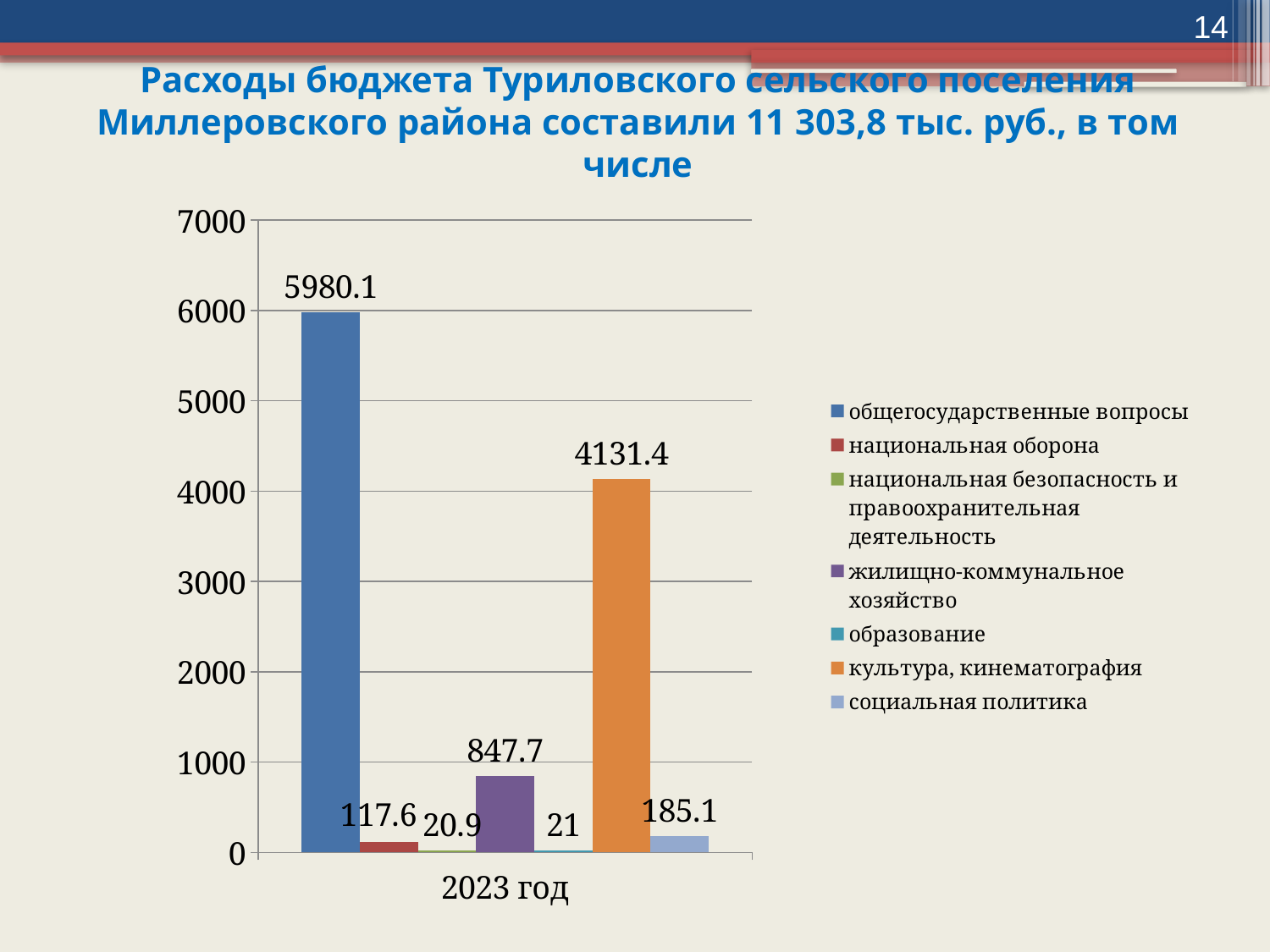
Which is larger: жилищно-коммунальное хозяйство or социальная политика? жилищно-коммунальное хозяйство What is the value for социальная политика in 2023 год? 185.1 What is the value for культура, кинематография in 2023 год? 4131.4 What is the x-axis category label shown under the bars? 2023 год Which series has the highest value in 2023 год? общегосударственные вопросы What is the difference between общегосударственные вопросы and культура, кинематография? 1848.7 How many series does the legend list? 7 What is the value for общегосударственные вопросы in 2023 год? 5980.1 What is the value for национальная оборона in 2023 год? 117.6 Is the value for культура, кинематография greater or less than 4000? greater What type of chart is shown on the slide? bar chart What is the value for жилищно-коммунальное хозяйство in 2023 год? 847.7